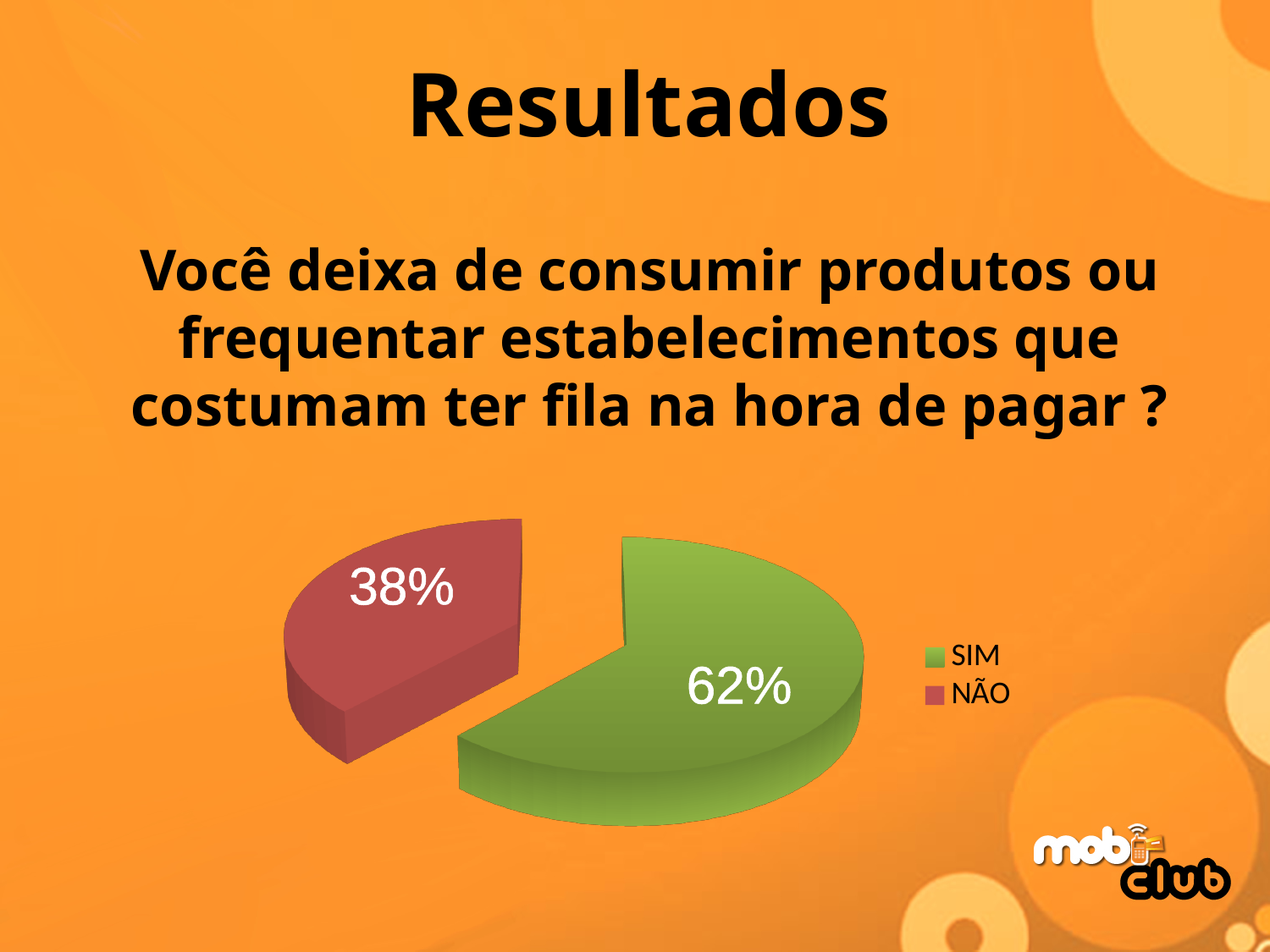
Which slice is the smallest? NÃO Which slice is the largest? SIM What share of the pie does NÃO represent? 38% Which is larger, SIM or NÃO? SIM What colour is the SIM slice? green What colour is the NÃO slice? red What kind of chart is shown on the slide? pie chart What is the difference in percentage points between SIM and NÃO? 24 What share of the pie does SIM represent? 62% How many slices does the pie chart have? 2 How many entries does the legend list? 2